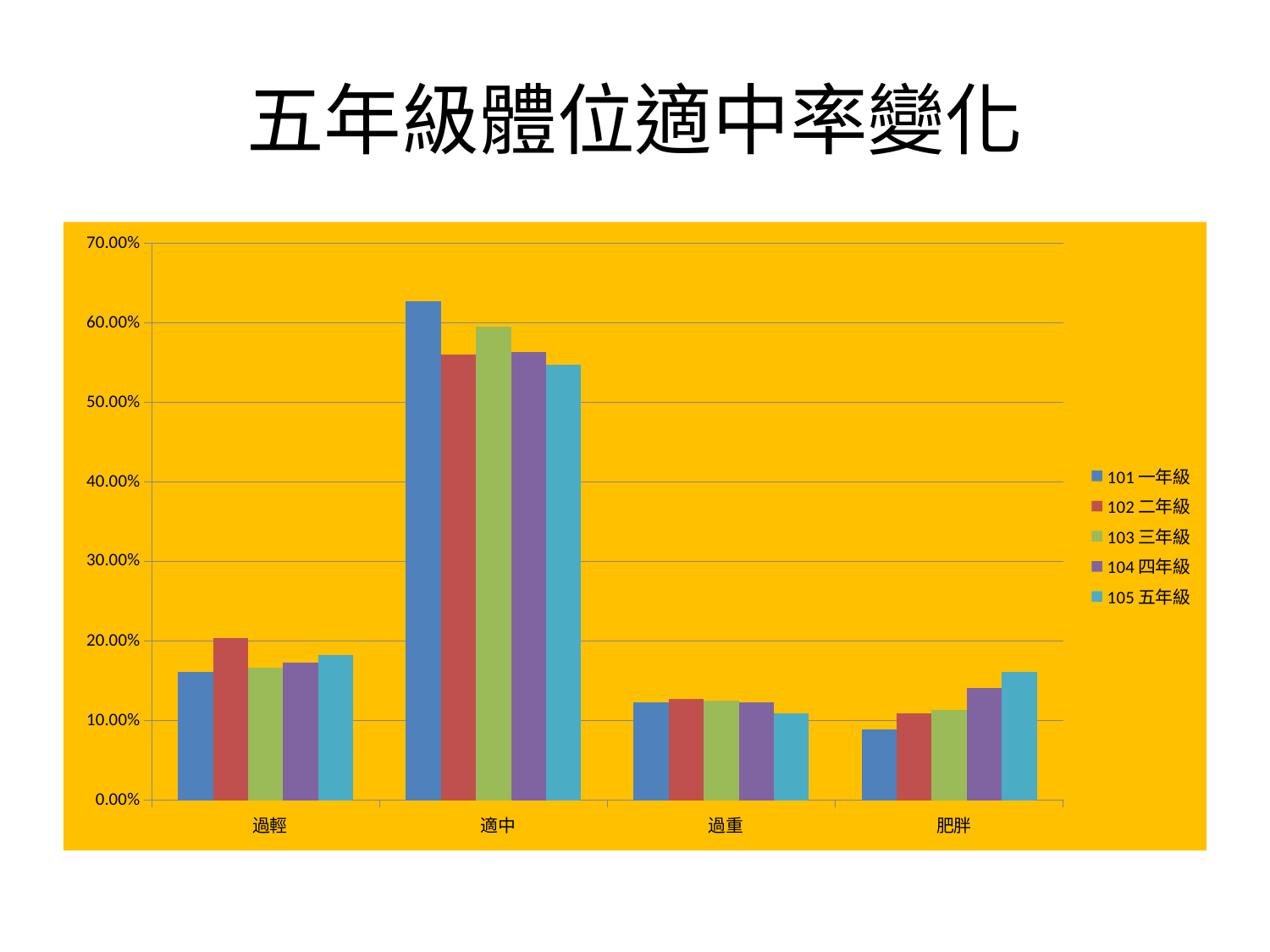
For the 肥胖 category, which series has the lowest value? 101 一年級 What is the title of the slide? 五年級體位適中率變化 What kind of chart is shown on the slide? bar chart For the 過輕 category, which is larger: the 101 一年級 value or the 102 二年級 value? 102 二年級 Which category has the highest value for the 101 一年級 series? 適中 For the 肥胖 category, do the values rise or fall from 101 一年級 to 105 五年級? rise Is the value for 適中 in the 101 一年級 series greater or less than 60.00%? greater Is the value for 肥胖 in the 101 一年級 series greater or less than 10.00%? less How many categories are shown on the x axis of the chart? 4 For the 適中 category, which is larger: the 101 一年級 value or the 102 二年級 value? 101 一年級 How many series does the legend list? 5 Is the value for 適中 in the 105 五年級 series greater or less than 60.00%? less